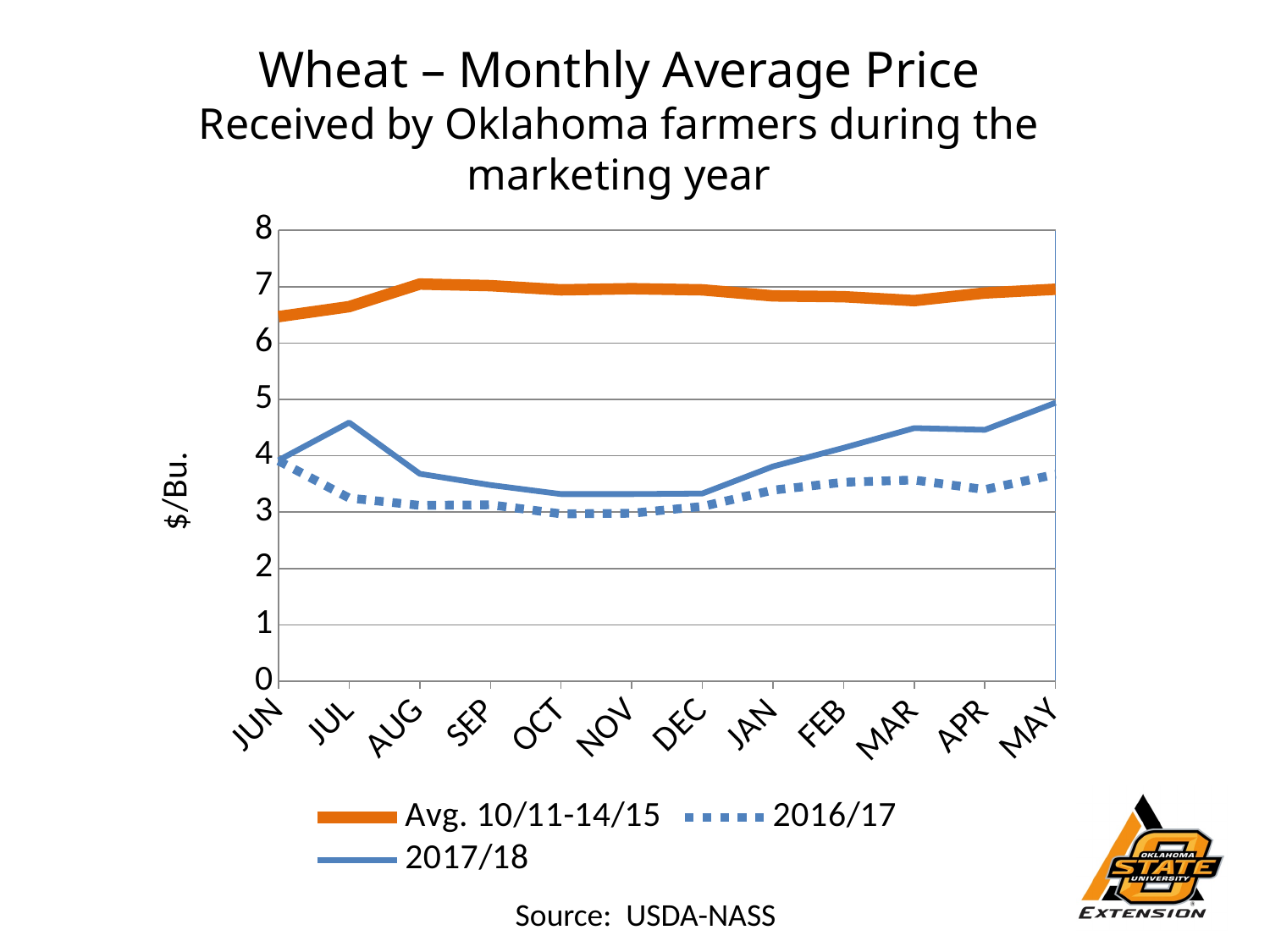
How many series does the legend list? 3 In which month does the 2016/17 series reach its highest value? JUN Is the value for 2017/18 in OCT greater or less than 4? less What kind of chart is shown on the slide? line chart What is the label on the y axis? $/Bu. How many months are shown along the x axis? 12 Which series has the highest values across the whole marketing year? Avg. 10/11-14/15 In JUL, which series has the higher value: 2016/17 or 2017/18? 2017/18 Is the value for 2016/17 in MAY greater or less than 4? less Is the value for Avg. 10/11-14/15 in JUN greater or less than 7? less Does the 2017/18 series rise or fall from DEC to MAY? rise